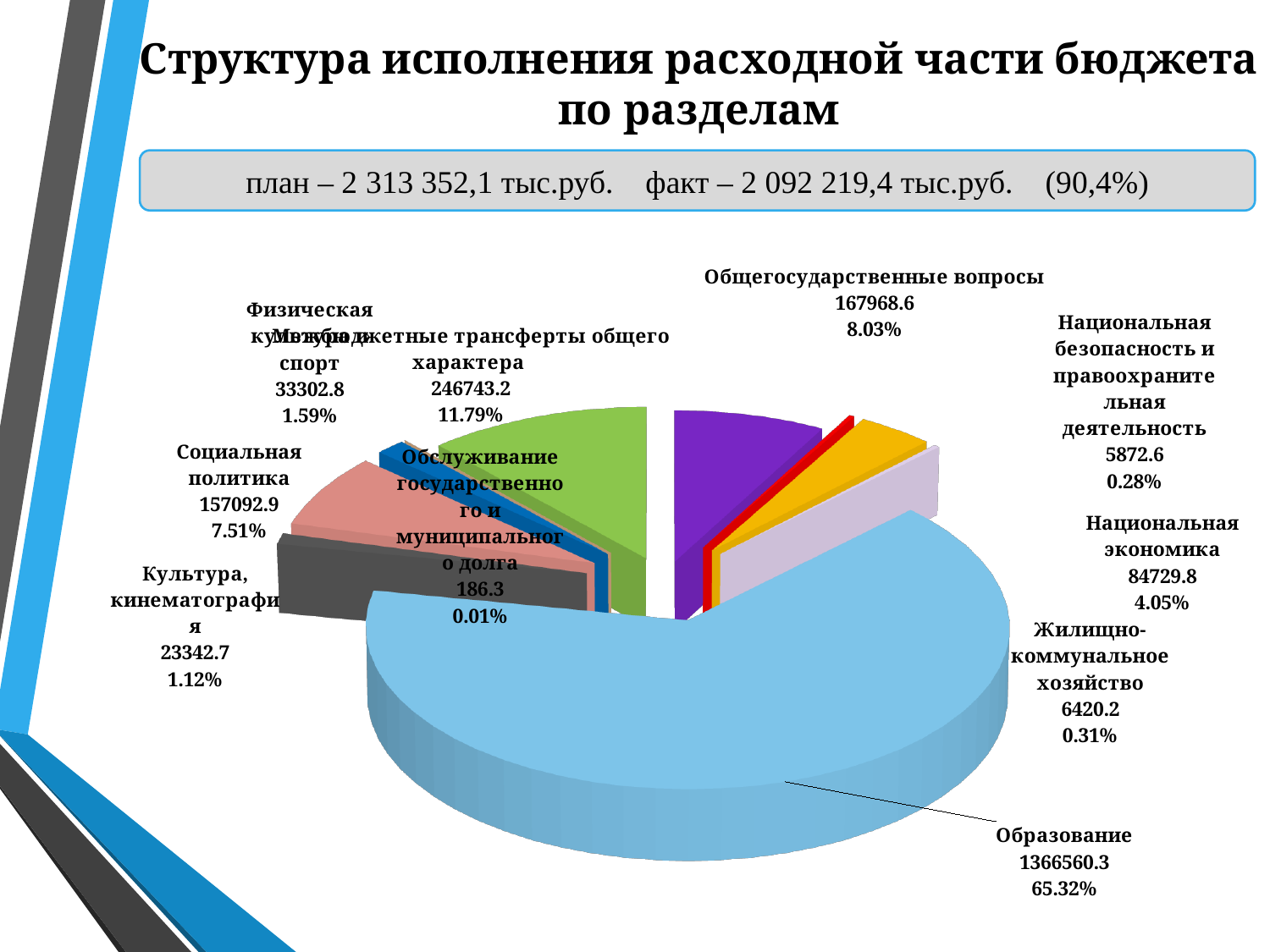
How many categories (slices) does the pie chart show? 10 What is the difference between the values for Социальная политика and Национальная экономика? 72363.1 What share of the pie does Образование account for? 65.32% What percentage is shown for Социальная политика? 7.51% What is the value shown for Культура, кинематография? 23342.7 What is the value shown for Межбюджетные трансферты общего характера? 246743.2 Which category has the smallest slice of the pie? Обслуживание государственного и муниципального долга What kind of chart is shown on the slide? pie chart Which category has the largest slice of the pie? Образование What percentage is shown for Жилищно-коммунальное хозяйство? 0.31% Which is larger: Общегосударственные вопросы or Национальная экономика? Общегосударственные вопросы What is the value shown for Образование? 1366560.3